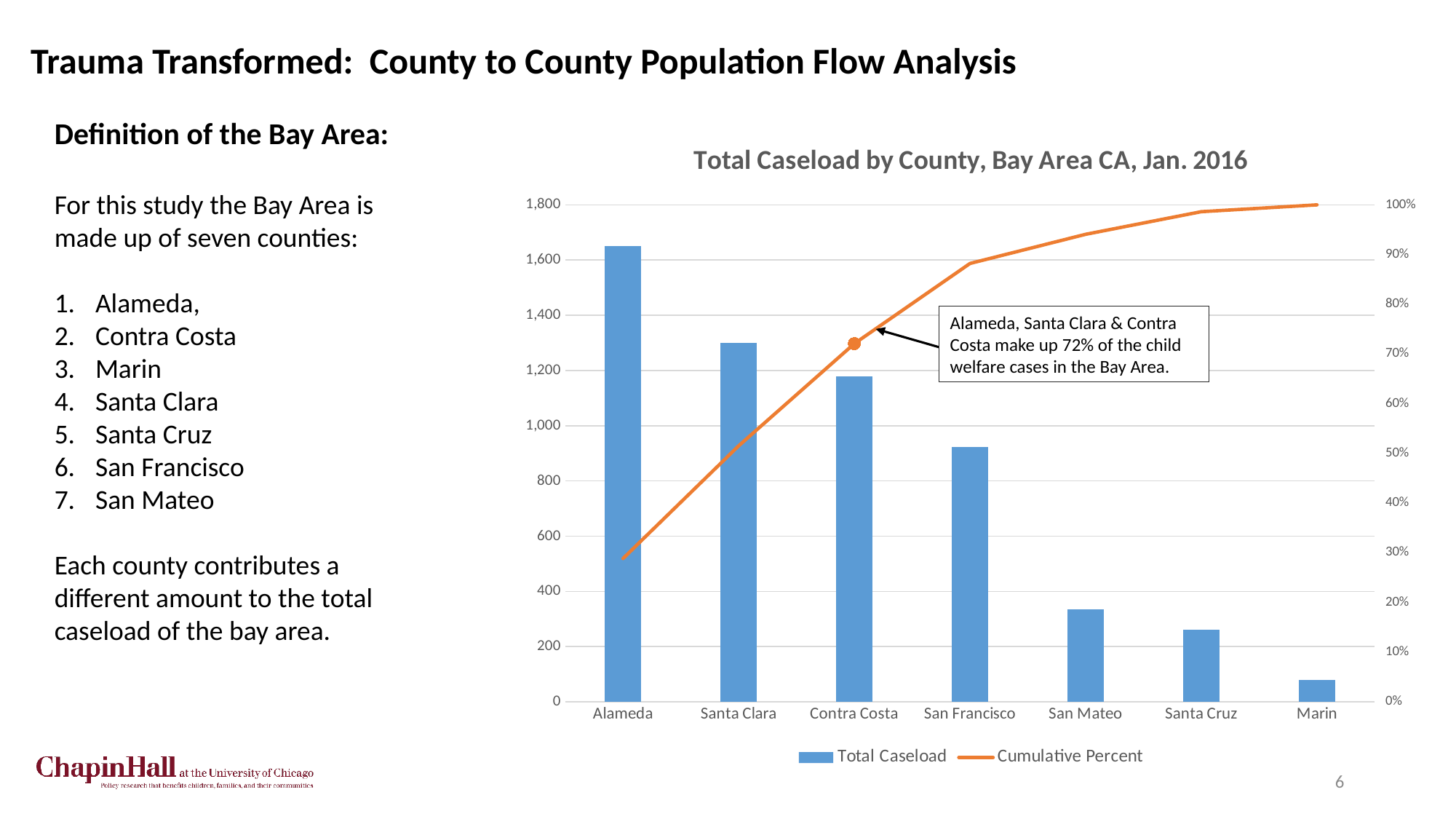
According to the annotation, what cumulative percent of Bay Area child welfare cases do Alameda, Santa Clara and Contra Costa make up? 72% What kind of chart is used to show the total caseload by county? Bar chart Which county has a larger total caseload, Santa Clara or Contra Costa? Santa Clara Which county has the lowest total caseload? Marin Is the total caseload for Alameda greater or less than 1,600? greater Do the total caseload bars rise or fall from left to right across the counties? Fall Which county has the highest total caseload? Alameda How many series does the chart legend list? 2 What is the title of the chart? Total Caseload by County, Bay Area CA, Jan. 2016 Is the total caseload for San Francisco greater or less than 1,000? less How many counties are shown on the x axis of the chart? 7 Is the total caseload for Marin greater or less than 200? less